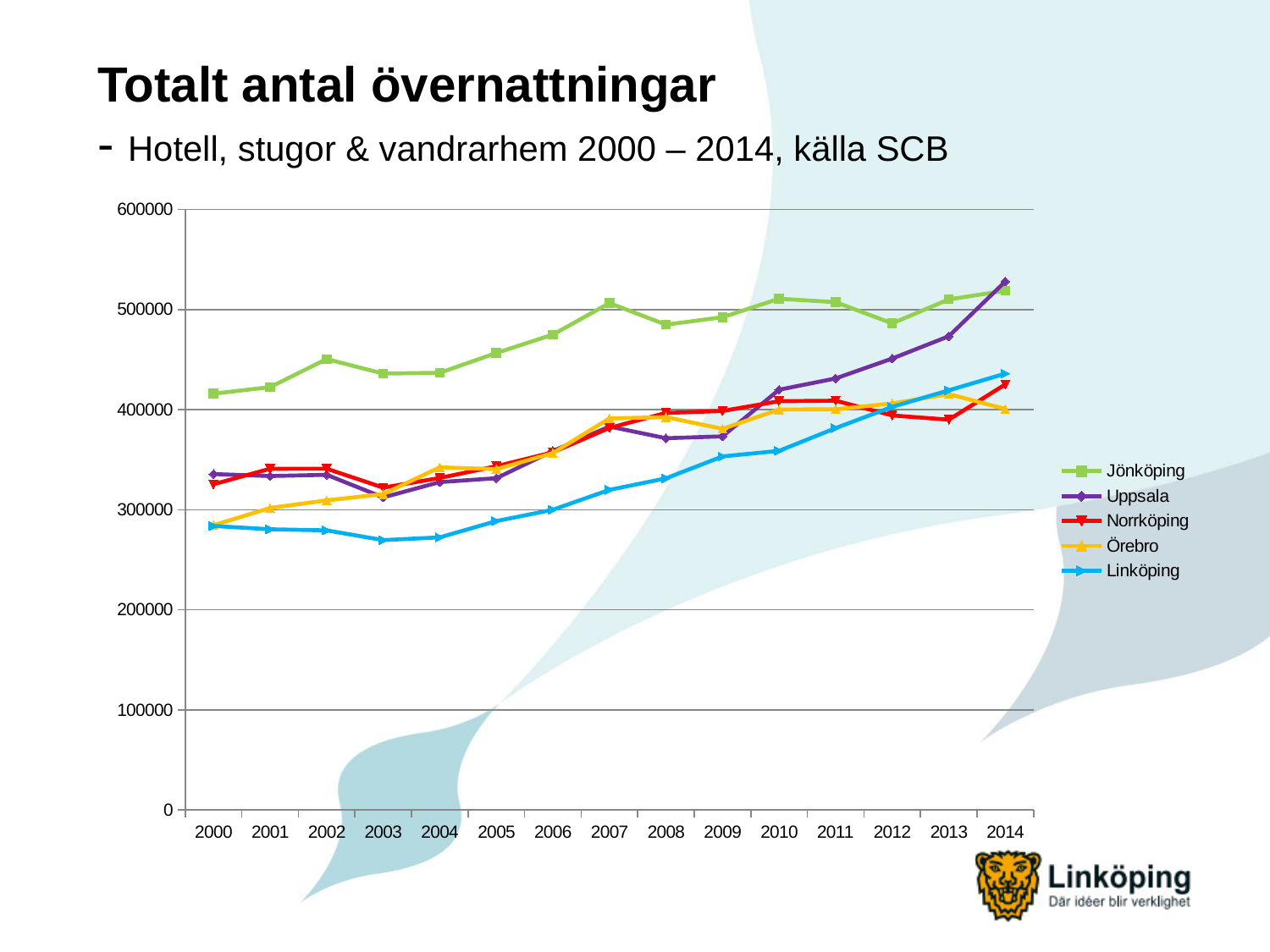
How many series does the legend list? 5 How many years are shown along the x axis? 15 Which series is shown in green in the legend? Jönköping Is the value for Jönköping in 2007 greater or less than 500000? greater Is the value for Linköping in 2003 greater or less than 300000? less Is the value for Uppsala in 2014 greater or less than 500000? greater Which is larger in 2010, the value for Jönköping or the value for Linköping? Jönköping Does the Linköping series generally rise or fall from 2003 to 2014? rise Which series has the highest value in 2000? Jönköping What kind of chart is shown on the slide? line chart Which series has the lowest value in 2003? Linköping